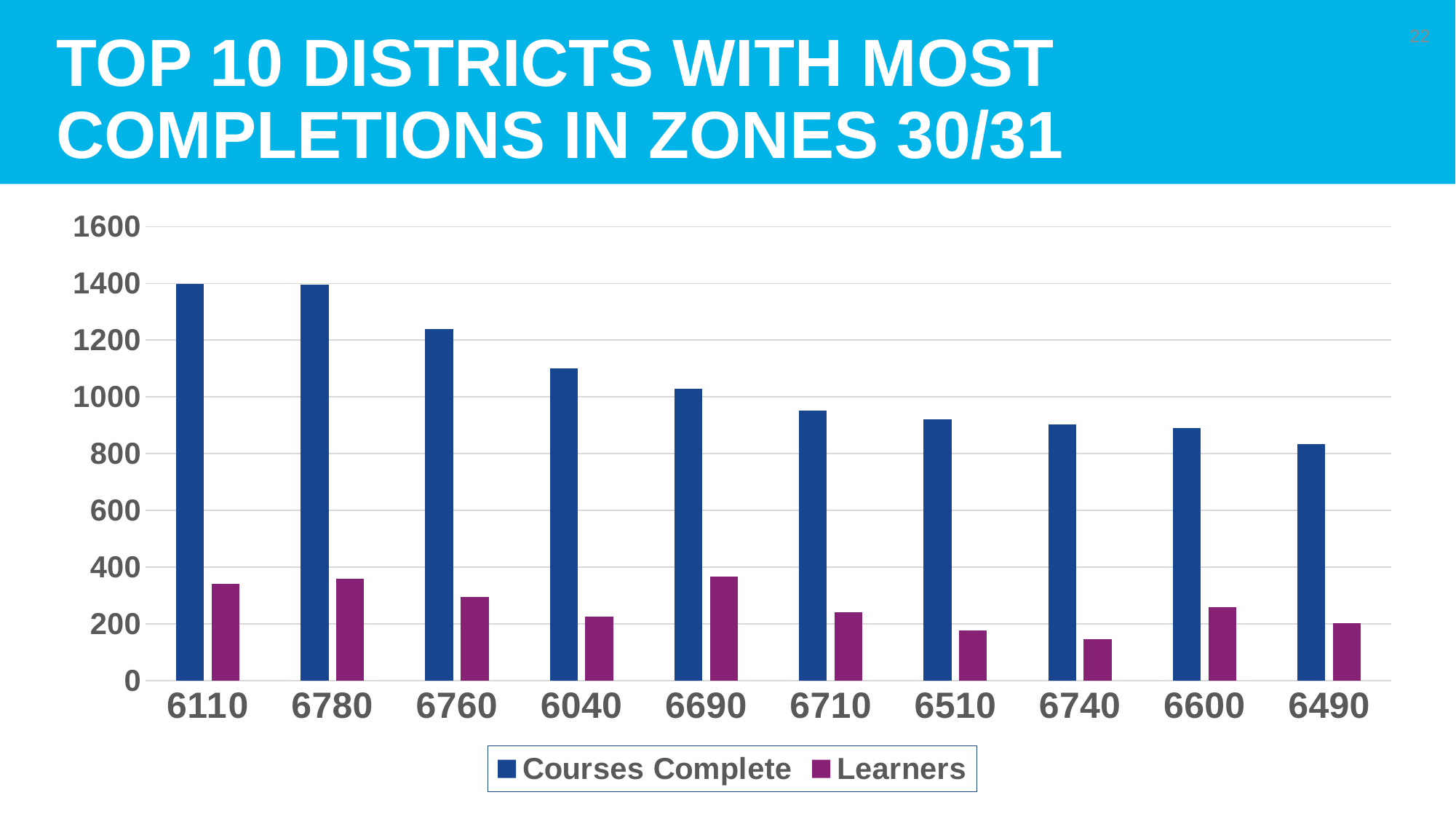
Which is larger, the Courses Complete value for district 6760 or for district 6040? 6760 Do the Courses Complete values rise or fall from left to right across the districts? fall Is the Learners value for district 6690 greater or less than 200? greater Which district has the lowest Learners value? 6740 What kind of chart is shown on the slide? bar chart How many districts are shown on the x axis? 10 Is the Learners value for district 6740 greater or less than 200? less How many series does the legend list? 2 Which district has the lowest Courses Complete value? 6490 Is the Courses Complete value for district 6760 greater or less than 1200? greater What colour are the Learners bars? purple